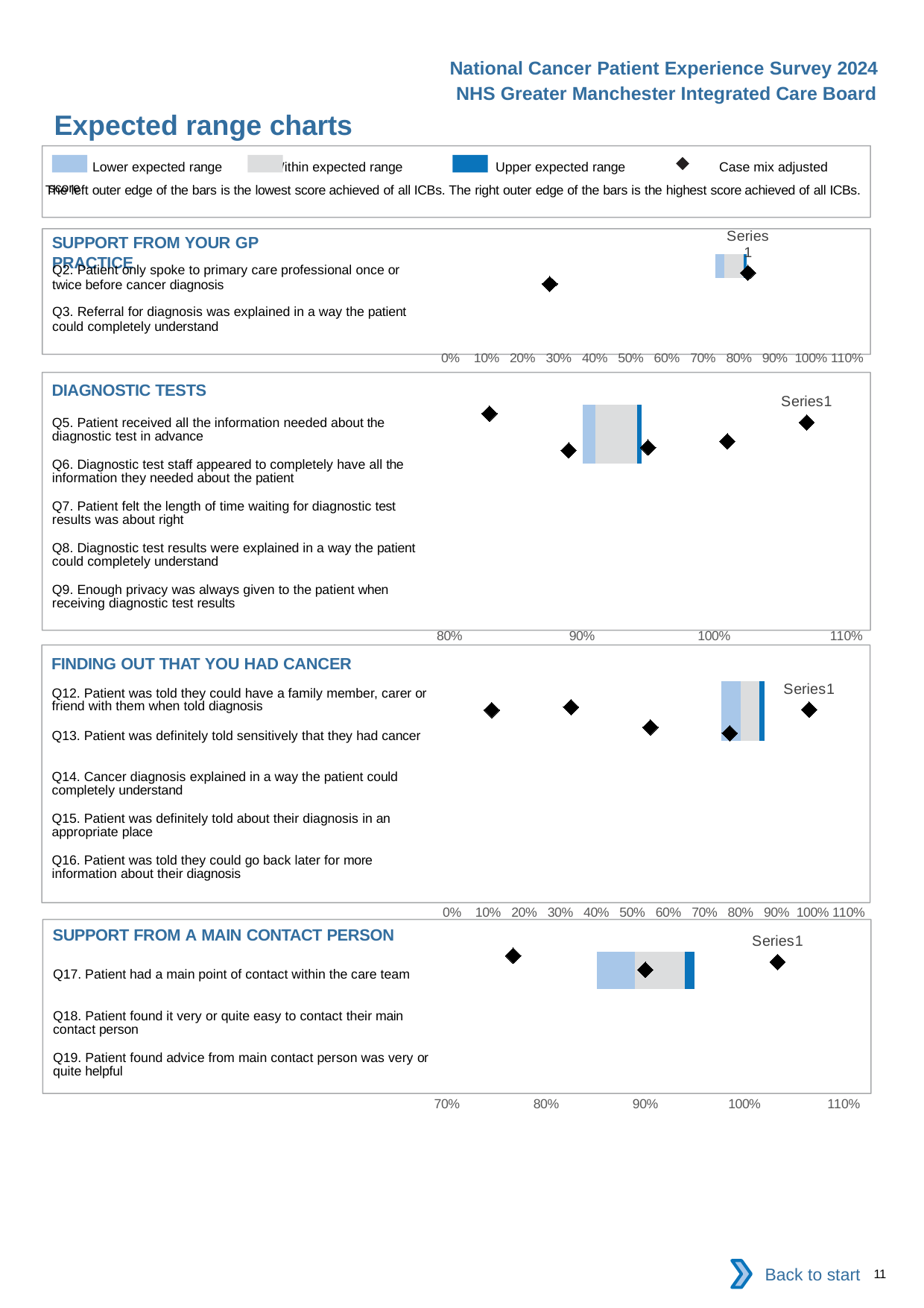
In the SUPPORT FROM A MAIN CONTACT PERSON chart, how many diamond markers are plotted? 3 In the FINDING OUT THAT YOU HAD CANCER chart, how many questions are listed as categories? 5 In the SUPPORT FROM YOUR GP PRACTICE chart, how many questions are listed as categories? 2 According to the legend at the top of the slide, what does the diamond marker represent? Case mix adjusted score What series name appears in the legend of the DIAGNOSTIC TESTS chart? Series1 In the DIAGNOSTIC TESTS chart, is the right edge of the expected range bar greater or less than 100%? less In the SUPPORT FROM A MAIN CONTACT PERSON chart, is the left edge of the expected range bar greater or less than 80%? greater What kind of chart is the DIAGNOSTIC TESTS chart? bar chart